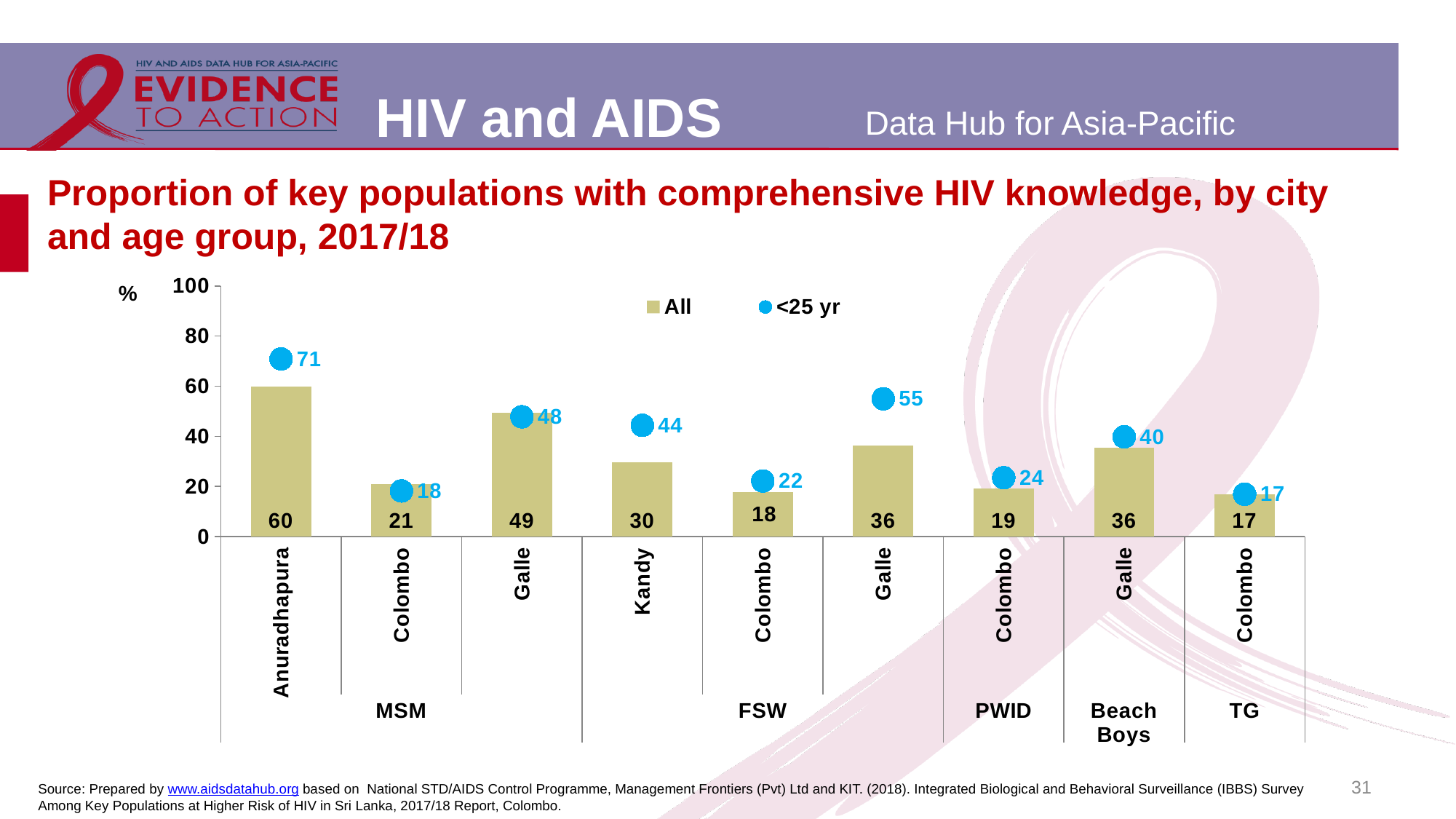
What kind of chart is used to show the 'All' series? Bar chart What is the '<25 yr' value for Beach Boys in Galle? 40 What colour are the '<25 yr' markers in the chart? Blue How many series does the legend list? 2 Which is larger for FSW in Kandy: the 'All' value or the '<25 yr' value? <25 yr How many city bars are plotted in the chart? 9 Which city and key population has the lowest 'All' value? Colombo (TG) Which city and key population has the highest '<25 yr' value? Anuradhapura (MSM) What is the 'All' value for MSM in Anuradhapura? 60 What is the 'All' value for PWID in Colombo? 19 What is the difference between the '<25 yr' value and the 'All' value for MSM in Anuradhapura? 11 What is the '<25 yr' value for FSW in Galle? 55